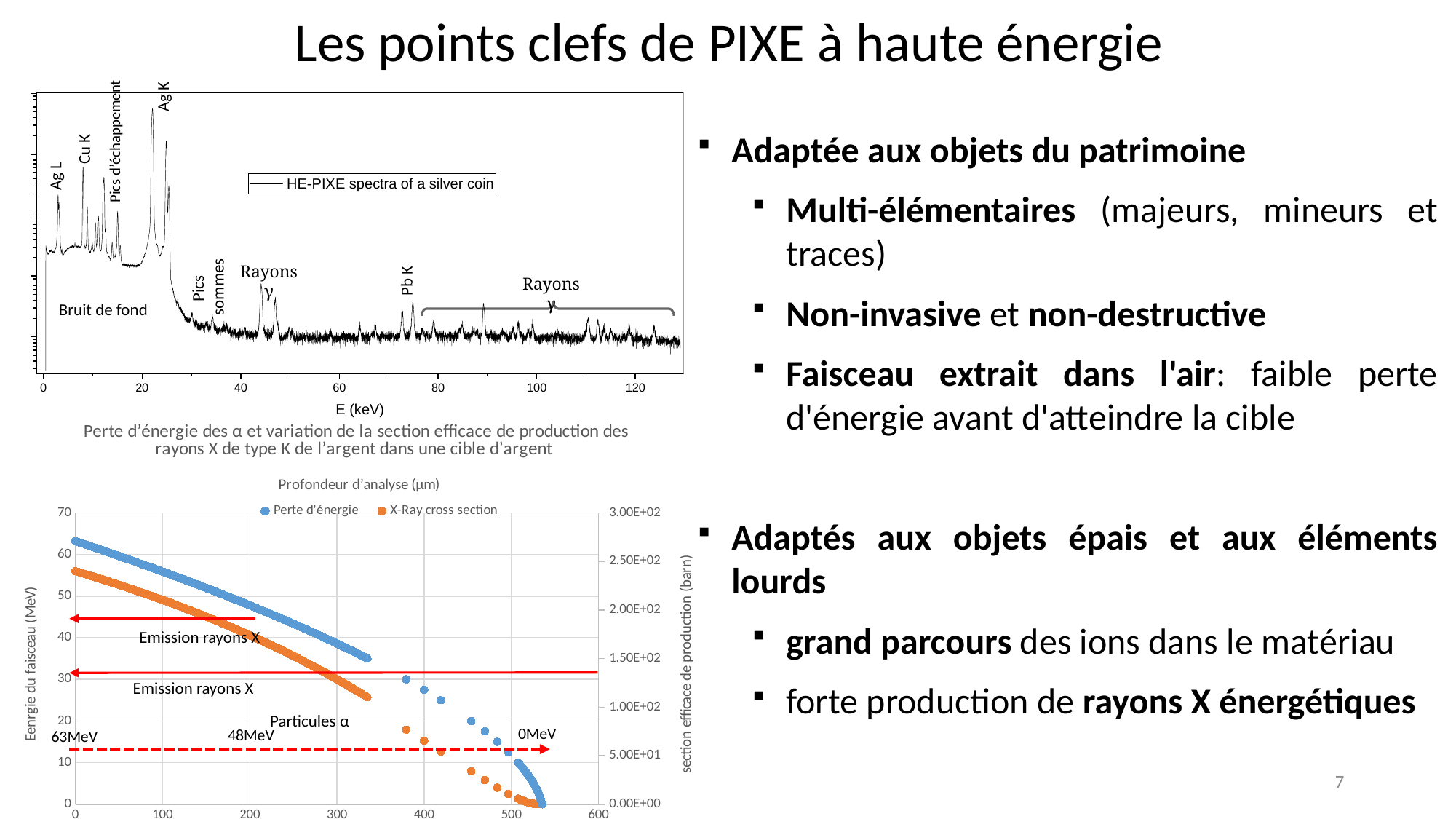
In the bottom chart, which colour represents the 'X-Ray cross section' series? orange What is the x-axis label of the top chart? E (keV) How many series does the legend of the bottom chart list? 2 In the bottom chart, is the 'Perte d'énergie' value at depth 300 µm greater or less than 30 MeV? greater In the top chart, which labelled peak is the highest? Ag K What kind of chart is the top chart, 'HE-PIXE spectra of a silver coin'? line chart In the bottom chart, is the 'Perte d'énergie' value at depth 0 greater or less than 60 MeV? greater In the top chart, which peak is higher, Ag K or Pb K? Ag K In the bottom chart, does the 'Perte d'énergie' series rise or fall as the depth increases along the x axis? fall In the bottom chart, is the 'X-Ray cross section' value at depth 0 greater or less than 2.00E+02 barn? greater How many series does the legend of the top chart list? 1 What kind of chart is the bottom chart, with x-axis 'Profondeur d'analyse (µm)'? scatter chart